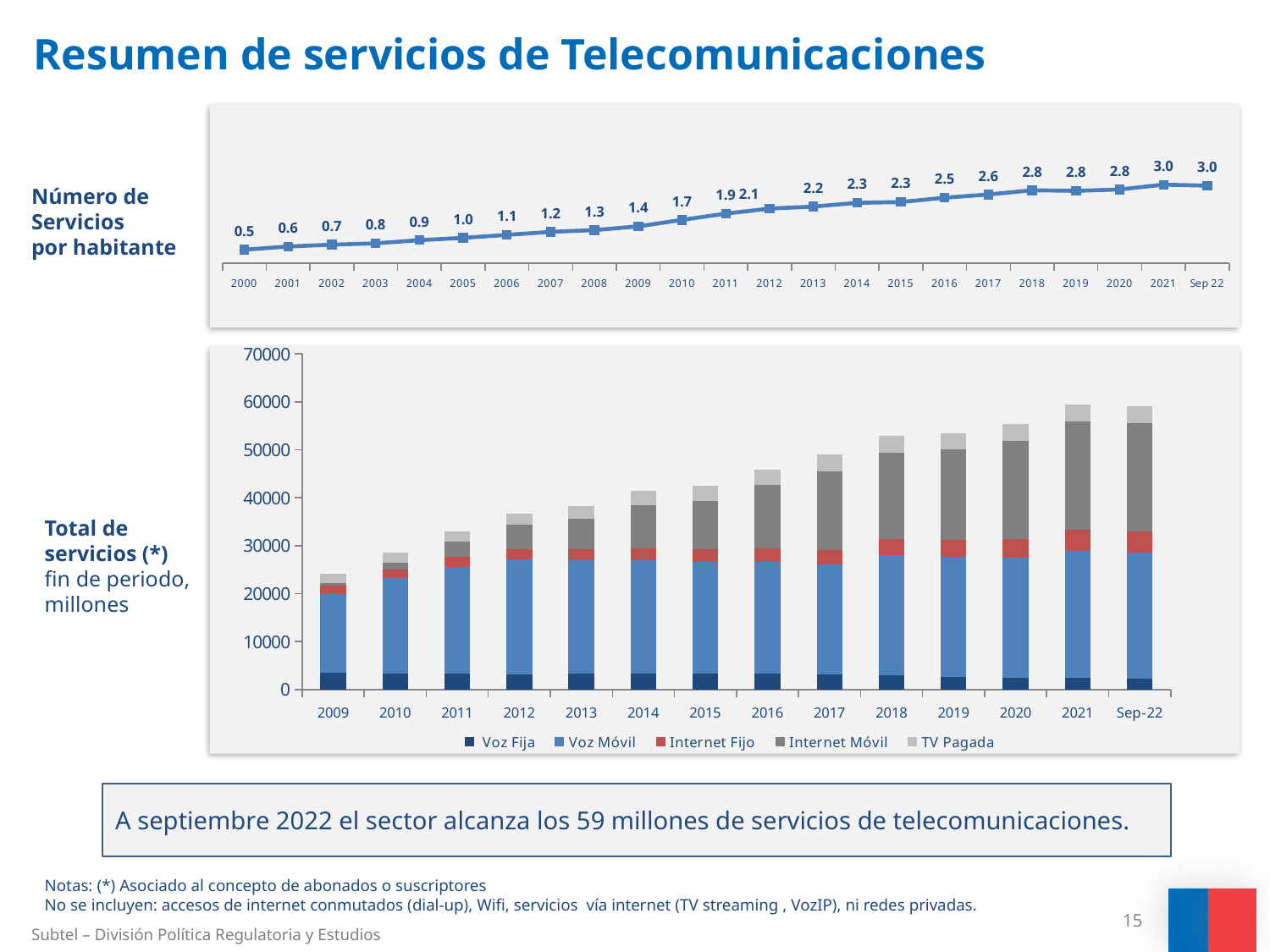
In the bottom chart (Total de servicios), is the total height of the 2009 bar greater or less than 30000? less In the top chart (Número de Servicios por habitante), do the values generally rise or fall from 2000 to Sep 22? rise What kind of chart is the top chart (Número de Servicios por habitante)? line chart In the bottom chart (Total de servicios), is the total height of the 2021 bar greater or less than 50000? greater How many data points are plotted in the top chart (Número de Servicios por habitante)? 23 How many series does the legend of the bottom chart (Total de servicios) list? 5 In the top chart (Número de Servicios por habitante), which is larger, the value for 2016 or the value for 2013? 2016 In the top chart (Número de Servicios por habitante), what is the value for Sep 22? 3.0 In the top chart (Número de Servicios por habitante), which year has the lowest value? 2000 In the top chart (Número de Servicios por habitante), what is the value for 2010? 1.7 What kind of chart is the bottom chart (Total de servicios)? stacked bar chart In the top chart (Número de Servicios por habitante), what is the difference between the values for 2021 and 2009? 1.6